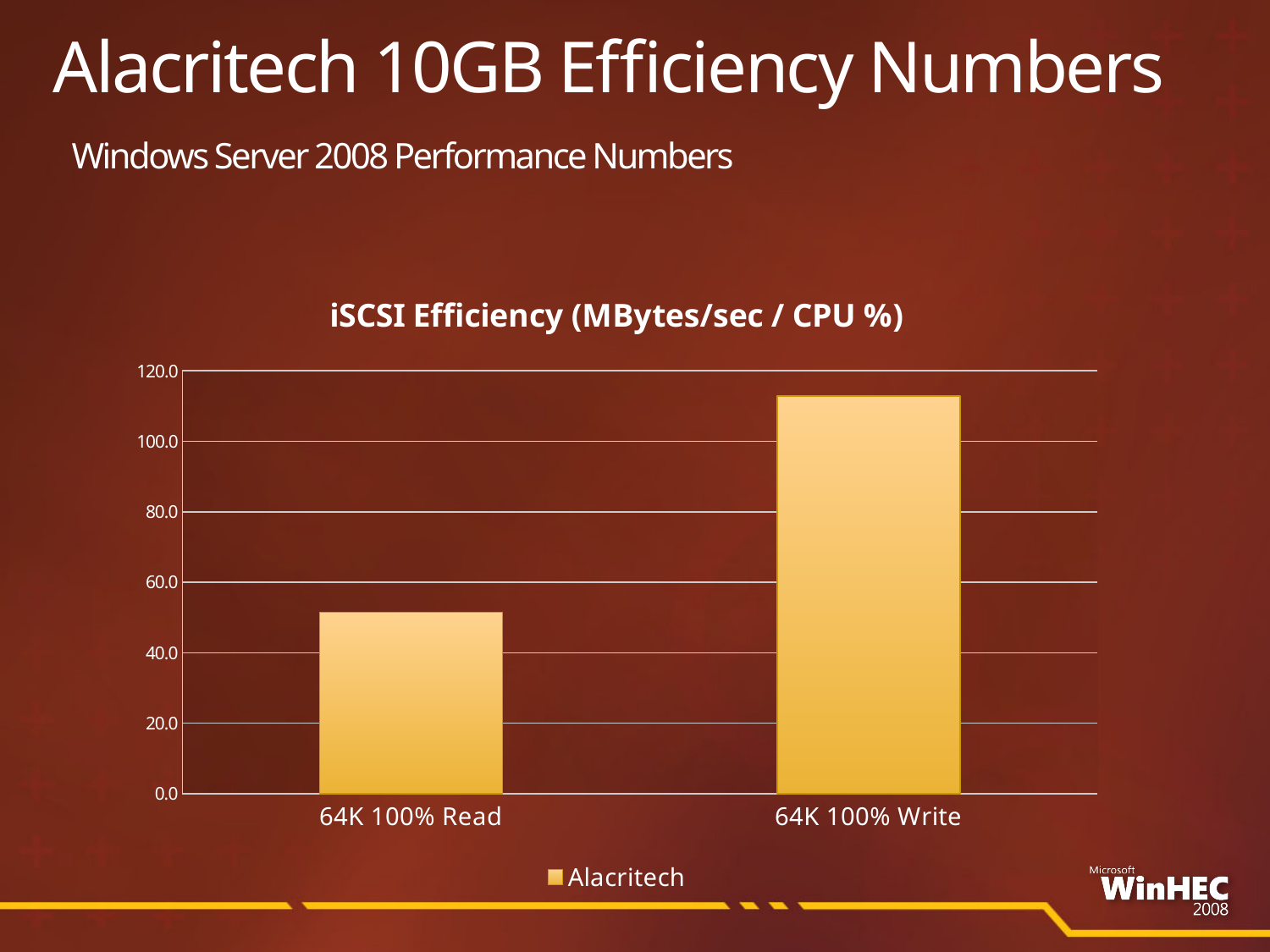
Which category has the highest value? 64K 100% Write Is the value for 64K 100% Read greater or less than 60.0? less Is the value for 64K 100% Read greater or less than 40.0? greater Which category has the lowest value? 64K 100% Read Do the values rise or fall from 64K 100% Read to 64K 100% Write? rise What series name appears in the legend? Alacritech Is the value for 64K 100% Write greater or less than 100.0? greater What is the title of the chart? iSCSI Efficiency (MBytes/sec / CPU %) What kind of chart is shown on the slide? bar chart How many categories are plotted on the x axis? 2 How many series does the legend list? 1 Which is larger, the value for 64K 100% Read or 64K 100% Write? 64K 100% Write